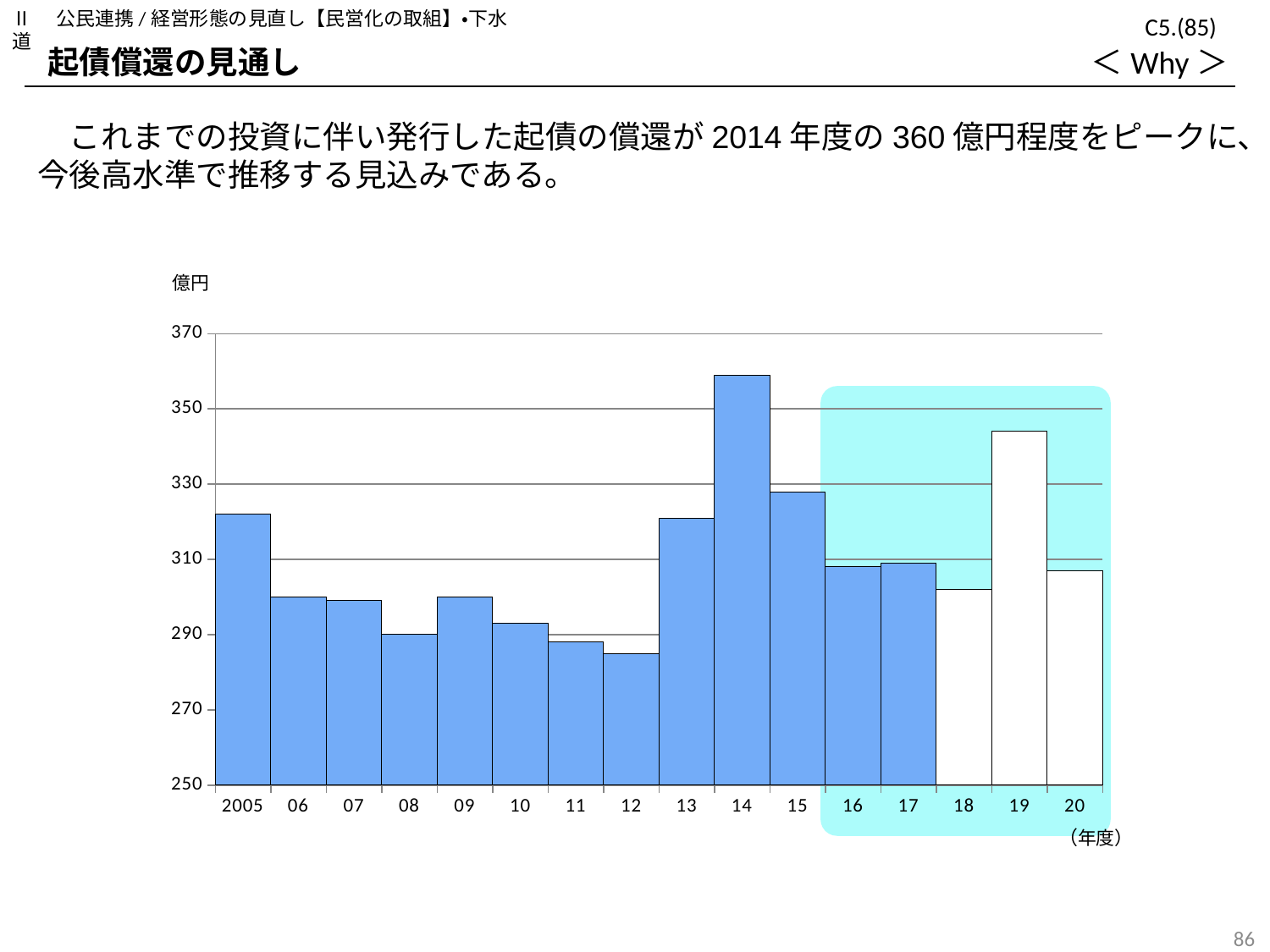
Which is larger, the value for 15 or the value for 16? 15 Which year has the highest bar in the chart? 14 Is the value for 19 greater or less than 350? less Is the value for 14 greater or less than 350? greater Is the value for 18 greater or less than 290? greater What kind of chart is shown on the slide? bar chart Do the values rise or fall from 12 to 14? rise What unit is shown at the top of the vertical axis? 億円 Which year has the lowest bar in the chart? 12 How many years (bars) are plotted in the chart? 16